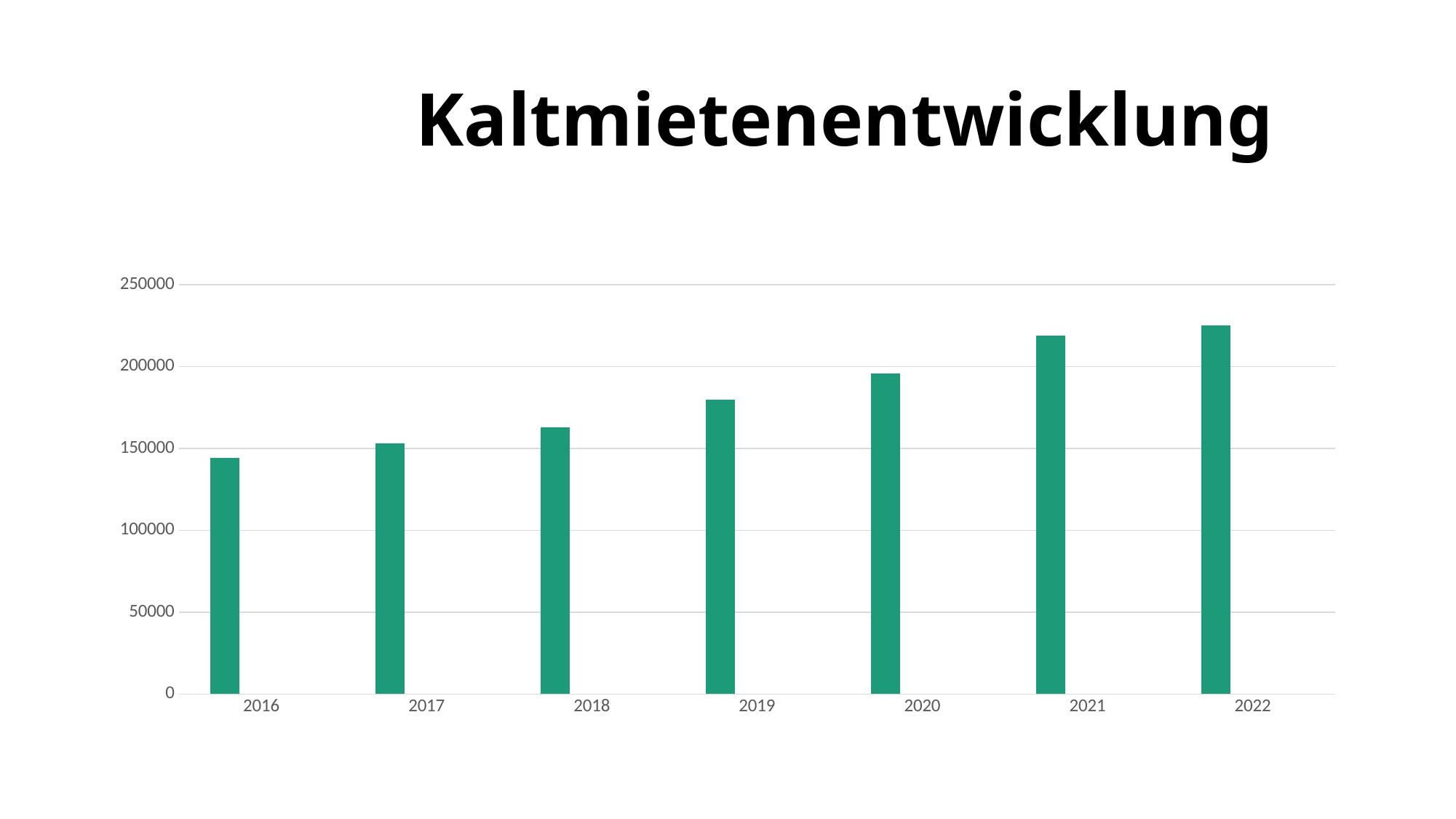
Which is larger, the value for 2017 or the value for 2020? 2020 Which year has the lowest value in the chart? 2016 Is the value for 2021 greater or less than 200000? greater Is the value for 2016 greater or less than 150000? less Is the value for 2019 greater or less than 200000? less How many years are shown on the x axis of the chart? 7 What is the title of the chart? Kaltmietenentwicklung What colour are the bars in the chart? green What kind of chart is shown on the slide? bar chart Which year has the highest value in the chart? 2022 Do the values rise or fall from 2016 to 2022? rise